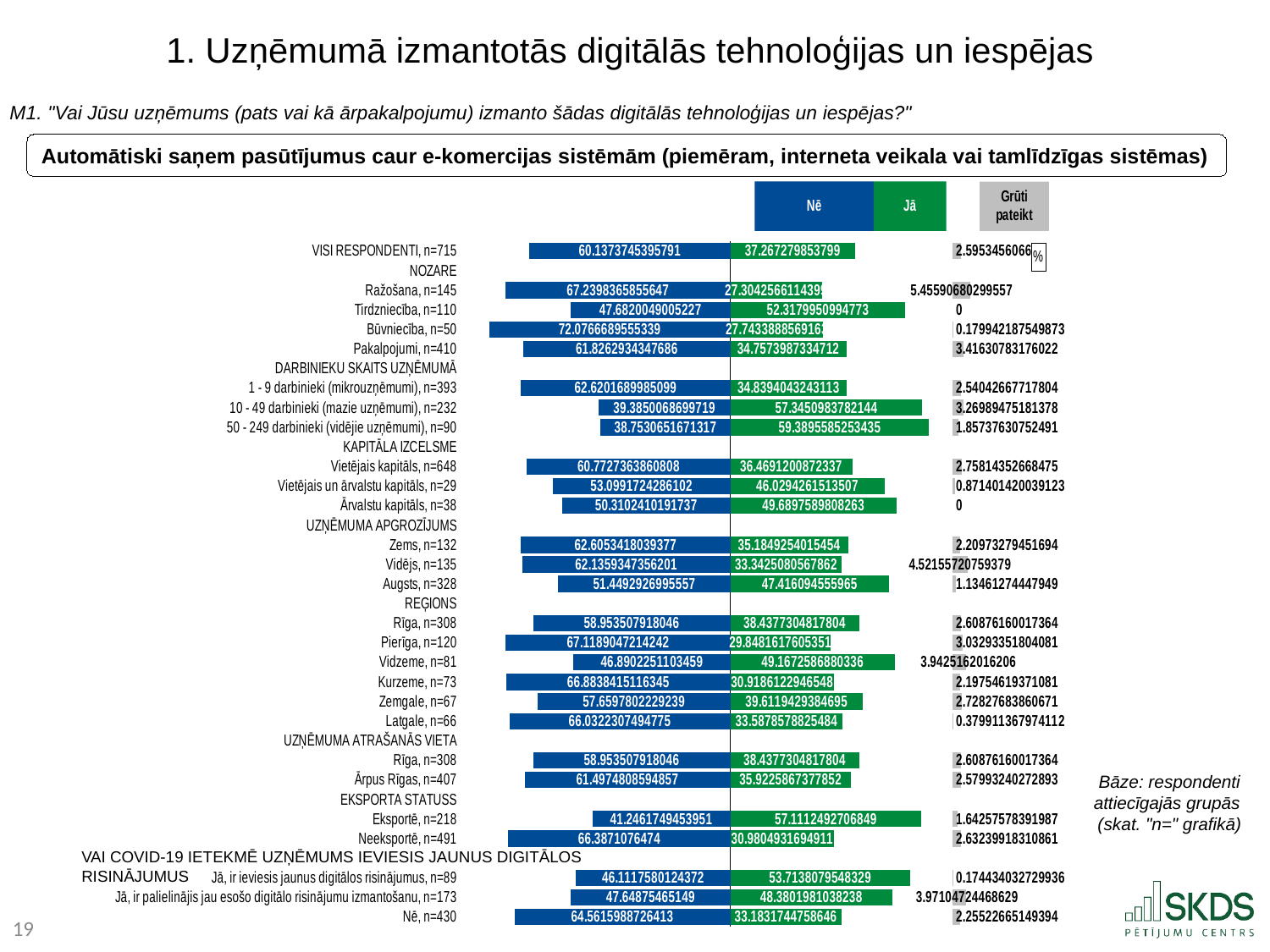
Which group has the highest "Nē" value? Būvniecība, n=50 For Tirdzniecība, n=110, which is larger: the "Nē" value or the "Jā" value? Jā What are the three legend entries of the chart? Nē, Jā, Grūti pateikt What is the "Nē" value for VISI RESPONDENTI, n=715? 60.1373745395791 What is the "Jā" value for Eksportē, n=218? 57.1112492706849 Which group has the lowest "Nē" value? 50 - 249 darbinieki (vidējie uzņēmumi), n=90 How many series does the legend list? 3 What is the "Grūti pateikt" value for Tirdzniecība, n=110? 0 What kind of chart is shown on the slide? bar chart What is the total of the stacked bar for Tirdzniecība, n=110? 100 What is the "Nē" value for Neeksportē, n=491? 66.3871076474 Which colour represents the "Jā" series in the chart? green